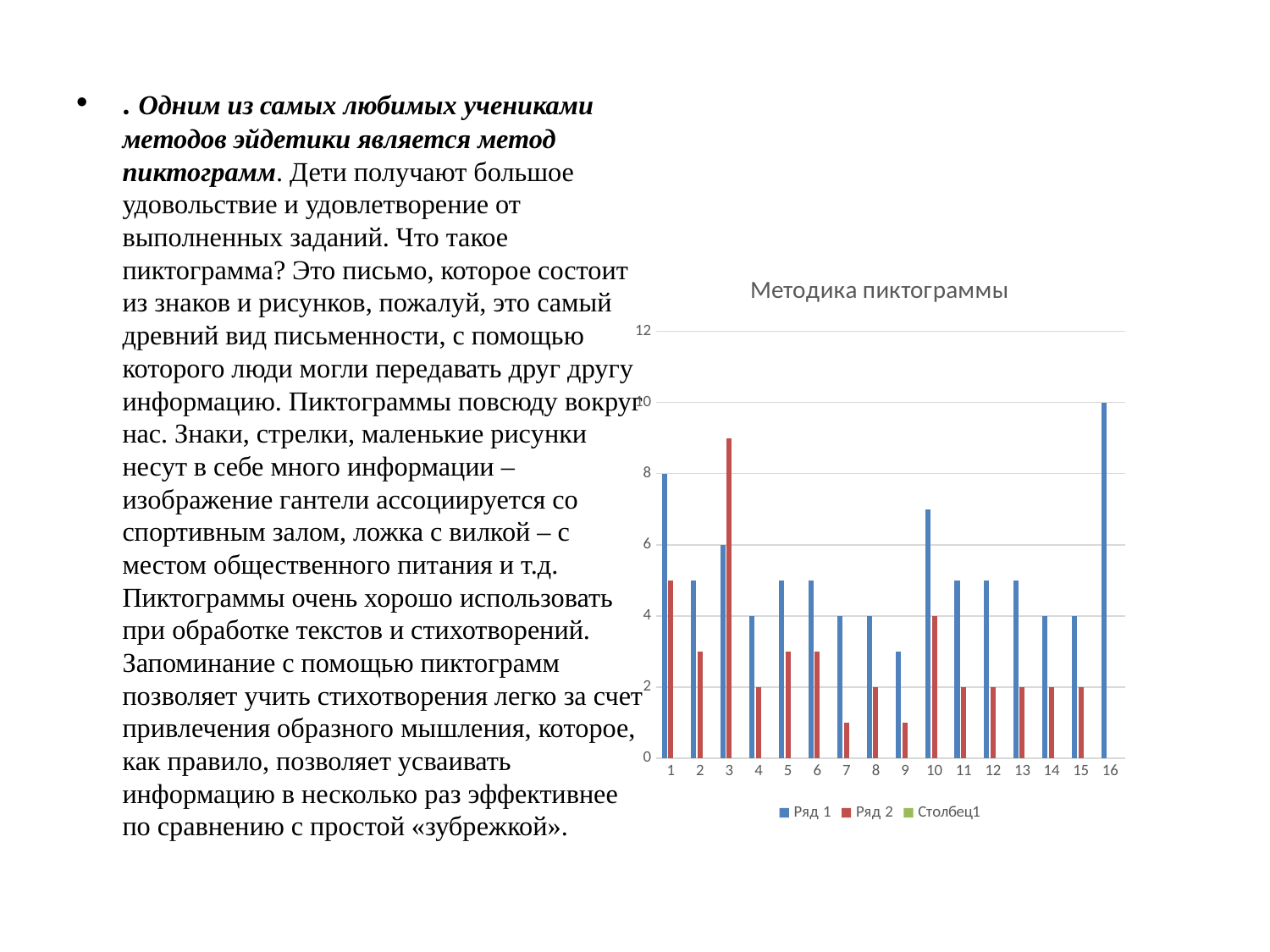
Is the value of Ряд 1 for category 10 greater or less than 6? greater What is the value of Ряд 1 for category 16? 10 How many categories are shown on the x axis? 16 For category 3, which series has the larger value, Ряд 1 or Ряд 2? Ряд 2 What is the difference between the Ряд 1 values for category 16 and category 1? 2 What is the title of the chart? Методика пиктограммы Which category has the highest value for Ряд 2? 3 Which category has the lowest value for Ряд 1? 9 What kind of chart is shown on the slide? bar chart How many series does the legend list? 3 Which category has the highest value for Ряд 1? 16 What is the value of Ряд 1 for category 1? 8